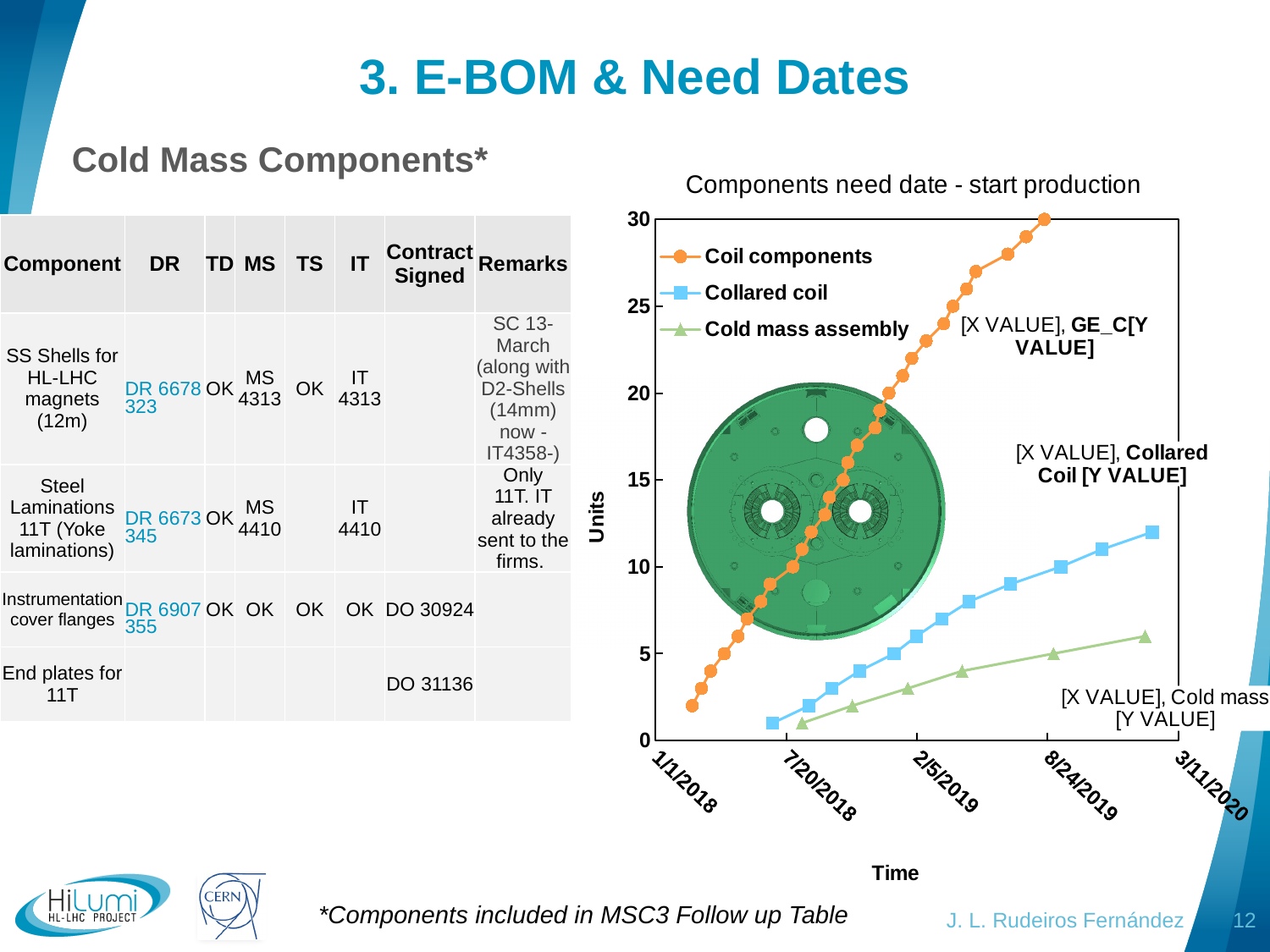
How many series does the chart legend list? 3 What type of chart is shown on the slide? line chart Which series stays lowest on the chart? Cold mass assembly What is the title of the chart? Components need date - start production Do the values of the Coil components series rise or fall over time? rise Which series are listed in the chart legend? Coil components, Collared coil, Cold mass assembly Which series reaches the highest number of units on the chart? Coil components At the end of the plotted period, which is larger: Collared coil or Cold mass assembly? Collared coil What value does the Coil components series reach at its final point? 30 What is the label of the vertical axis of the chart? Units Is the final value of the Collared coil series greater or less than 10? greater Is the final value of the Cold mass assembly series greater or less than 10? less